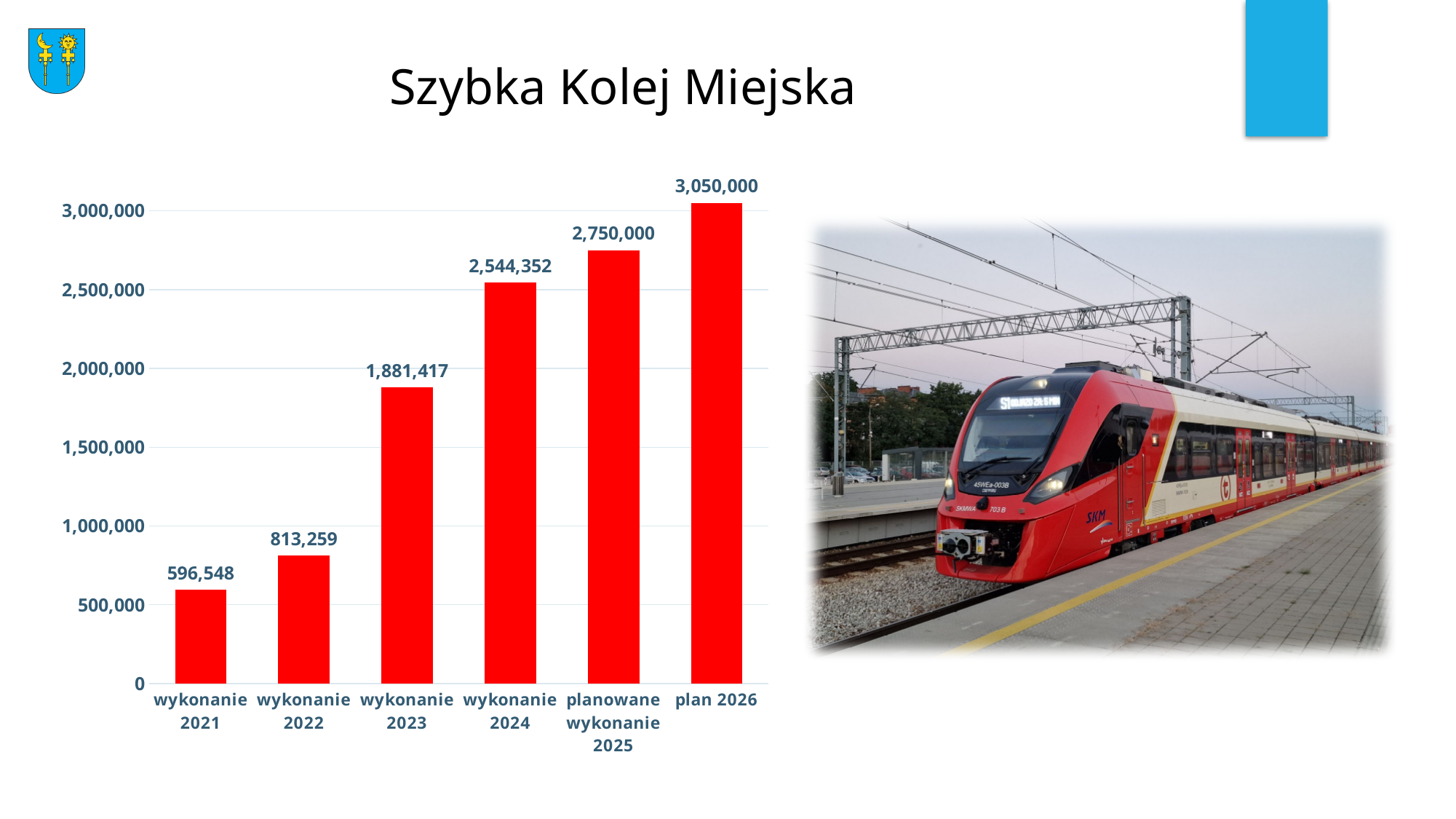
What kind of chart is shown on the slide? bar chart Do the values rise or fall from wykonanie 2021 to plan 2026? rise Which category has the highest value? plan 2026 What is the difference between the values for wykonanie 2022 and wykonanie 2021? 216,711 Which category has the lowest value? wykonanie 2021 What is the value for planowane wykonanie 2025? 2,750,000 What is the difference between the values for plan 2026 and planowane wykonanie 2025? 300,000 How many categories are shown on the x axis? 6 Is the value for wykonanie 2022 greater or less than 1,000,000? less What is the value for wykonanie 2021? 596,548 Which is larger, the value for wykonanie 2024 or the value for wykonanie 2023? wykonanie 2024 What is the value for wykonanie 2023? 1,881,417